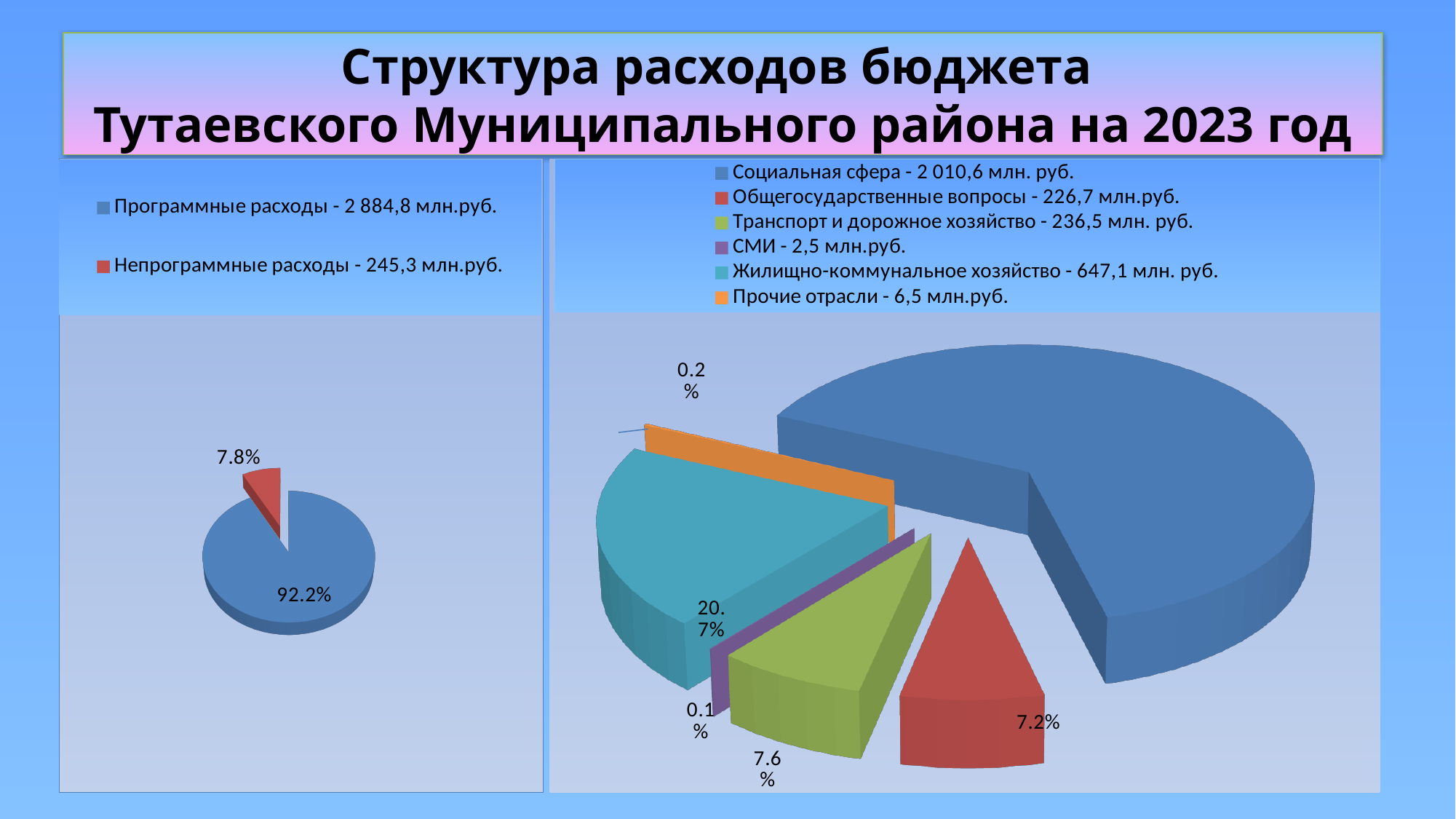
In the left pie chart, what is the value for Непрограммные расходы according to the legend? 245,3 млн.руб. In the left pie chart, what share of the pie does Программные расходы take? 92.2% In the right pie chart, what share of the pie does Общегосударственные вопросы take? 7.2% How many entries does the legend of the right pie chart list? 6 In the right pie chart, what is the value for СМИ according to the legend? 2,5 млн.руб. In the right pie chart, which category has the largest slice? Социальная сфера In the right pie chart, what share of the pie does Жилищно-коммунальное хозяйство take? 20.7% What kind of chart is shown on the left side of the slide? pie chart In the right pie chart, which is larger: the slice for Жилищно-коммунальное хозяйство or the slice for Транспорт и дорожное хозяйство? Жилищно-коммунальное хозяйство In the left pie chart, what is the value for Программные расходы according to the legend? 2 884,8 млн.руб.